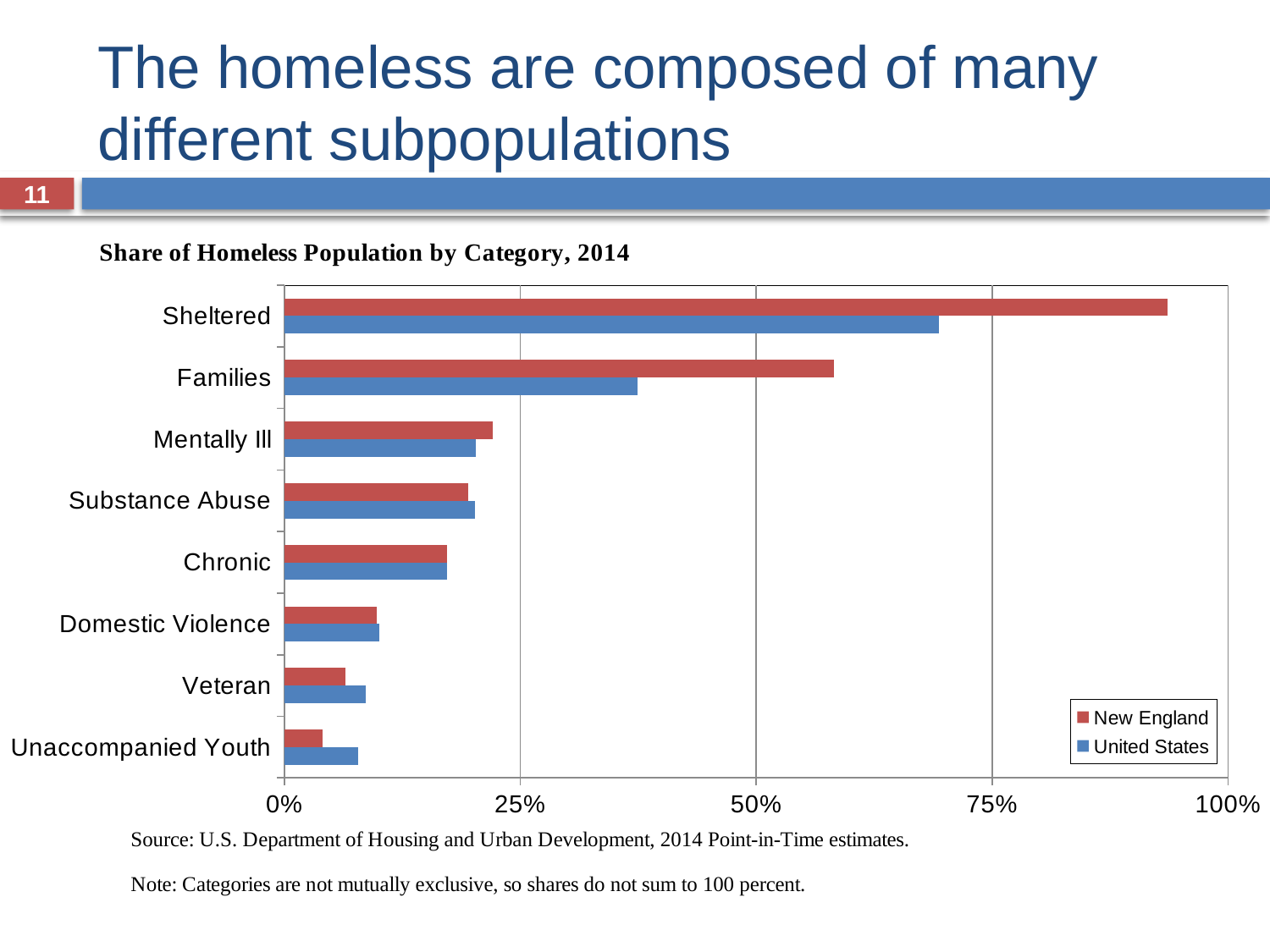
What kind of chart is shown on the slide? bar chart How many series does the legend list? 2 Which category has the lowest value for New England? Unaccompanied Youth For Unaccompanied Youth, which is larger: New England or United States? United States For Families, which is larger: New England or United States? New England Which category has the highest value for New England? Sheltered How many categories are shown on the chart? 8 Is the United States value for Sheltered greater or less than 75%? less Is the New England value for Sheltered greater or less than 75%? greater Is the United States value for Families greater or less than 50%? less What is the title of the chart? Share of Homeless Population by Category, 2014